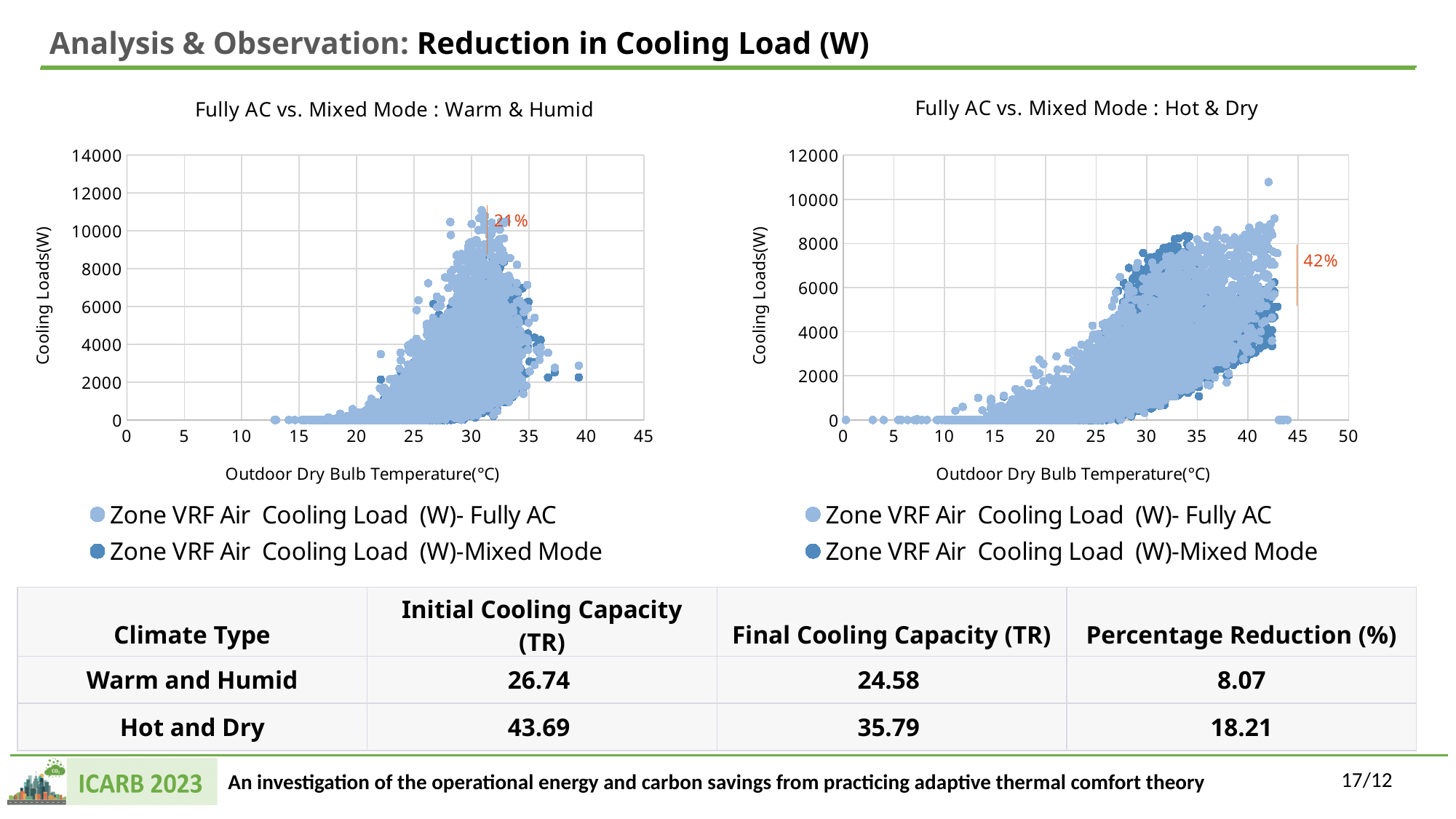
What kind of chart is the left chart titled "Fully AC vs. Mixed Mode : Warm & Humid"? Scatter chart What is the maximum value shown on the y axis of the left chart (Warm & Humid)? 14000 How many series does the legend list for the right chart titled "Fully AC vs. Mixed Mode : Hot & Dry"? 2 In the left chart (Warm & Humid), do cooling loads generally rise or fall as outdoor dry bulb temperature increases from 15°C to 30°C? Rise In the right chart (Hot & Dry), do cooling loads generally rise or fall as outdoor dry bulb temperature increases from 20°C to 40°C? Rise What is the x-axis label of the left chart (Warm & Humid)? Outdoor Dry Bulb Temperature(°C) Which chart shows the larger annotated percentage reduction, the Warm & Humid chart or the Hot & Dry chart? Hot & Dry In the right chart (Hot & Dry), what percentage reduction is annotated in orange at the right edge of the data? 42% In the right chart (Hot & Dry), is the highest plotted cooling load greater or less than 10000 W? greater In the left chart (Warm & Humid), what percentage reduction is annotated in orange near the peak of the data? 21% What is the maximum value shown on the x axis of the right chart (Hot & Dry)? 50 In the left chart (Warm & Humid), is the highest plotted cooling load greater or less than 12000 W? less